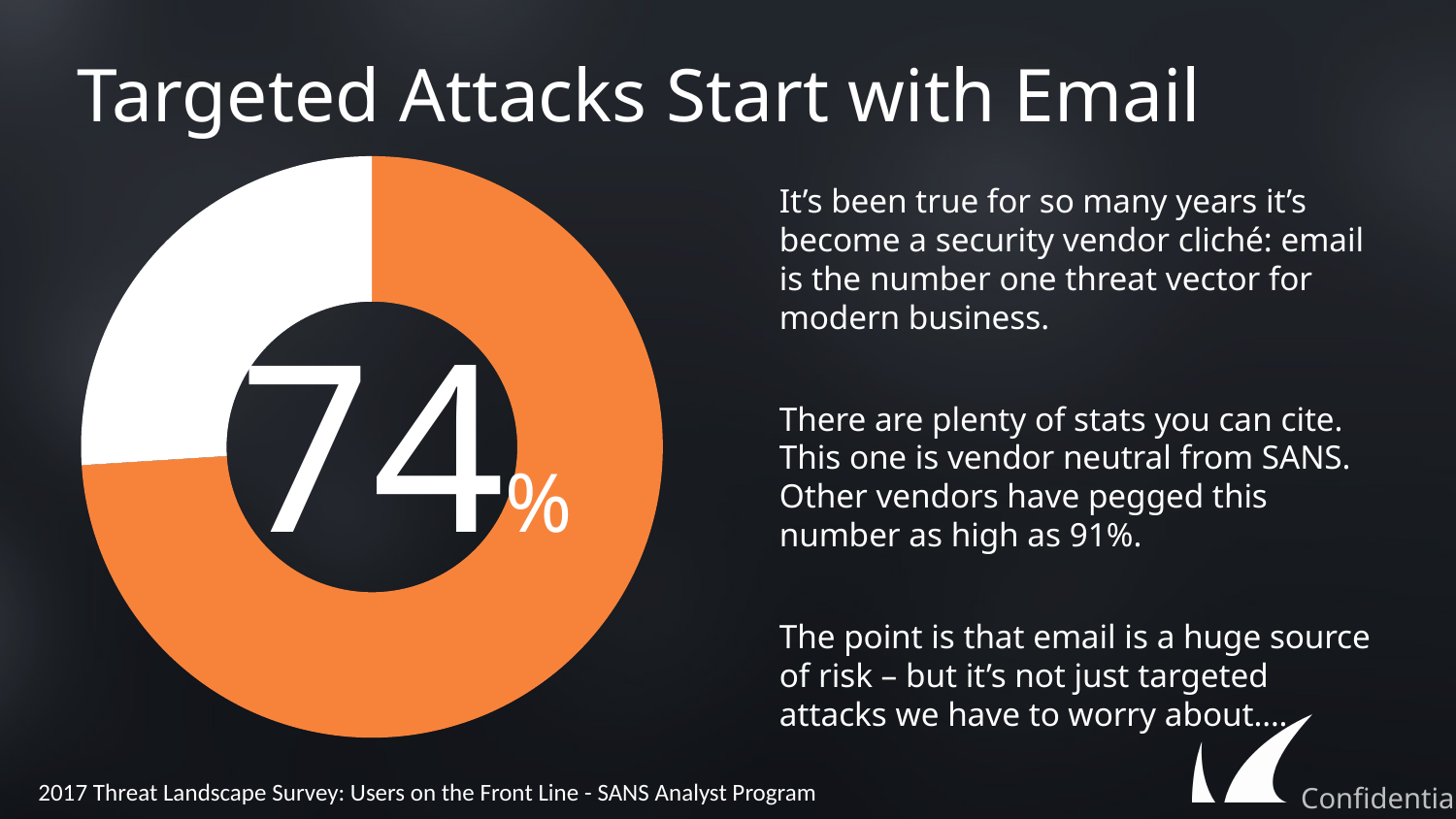
What percentage is printed in the centre of the donut chart? 74% Is the white segment of the donut chart greater or less than 50% of the whole? less What share of the donut chart does the orange segment represent? 74% What share of the donut chart does the white segment represent? 26% What is the title of the slide containing the donut chart? Targeted Attacks Start with Email Which segment of the donut chart is larger, the orange one or the white one? Orange What kind of chart is shown on the slide? Pie chart (donut) What colour is the larger segment of the donut chart? Orange How many segments does the donut chart have? 2 Is the orange segment of the donut chart greater or less than 50% of the whole? greater